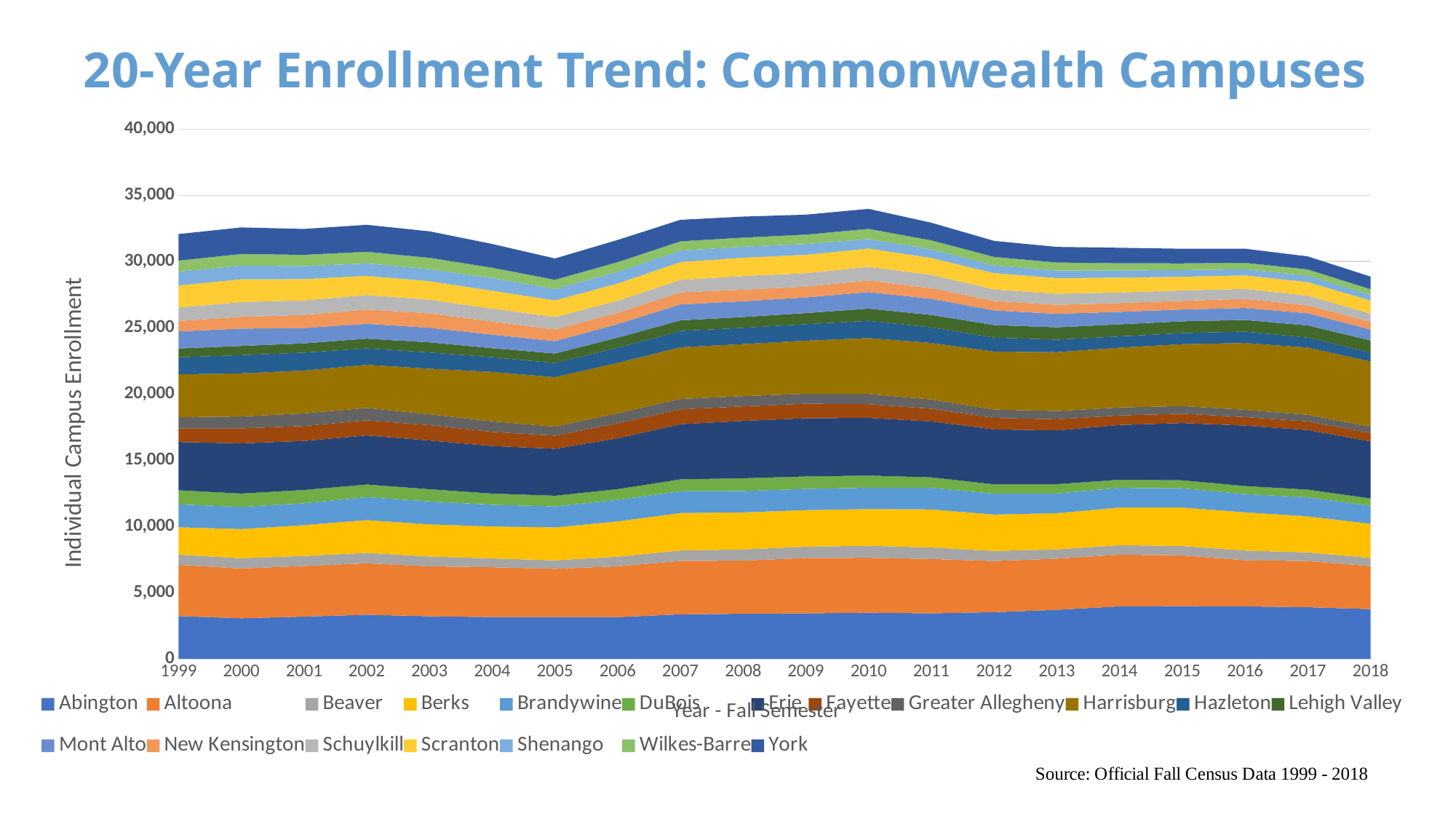
Is the total enrollment across all campuses in 2010 greater or less than 30,000? greater What is the title of the chart? 20-Year Enrollment Trend: Commonwealth Campuses Is the total enrollment across all campuses in 2018 greater or less than 30,000? less What kind of chart is shown on the slide? Stacked area chart What is the label on the vertical axis? Individual Campus Enrollment In which year is the total enrollment across all campuses lowest? 2018 Is the total enrollment across all campuses in 1999 greater or less than 30,000? greater In which year is the total enrollment across all campuses highest? 2010 How many campuses (series) does the legend list? 19 How many years are plotted along the x axis? 20 Does the total enrollment across all campuses rise or fall from 2010 to 2018? fall